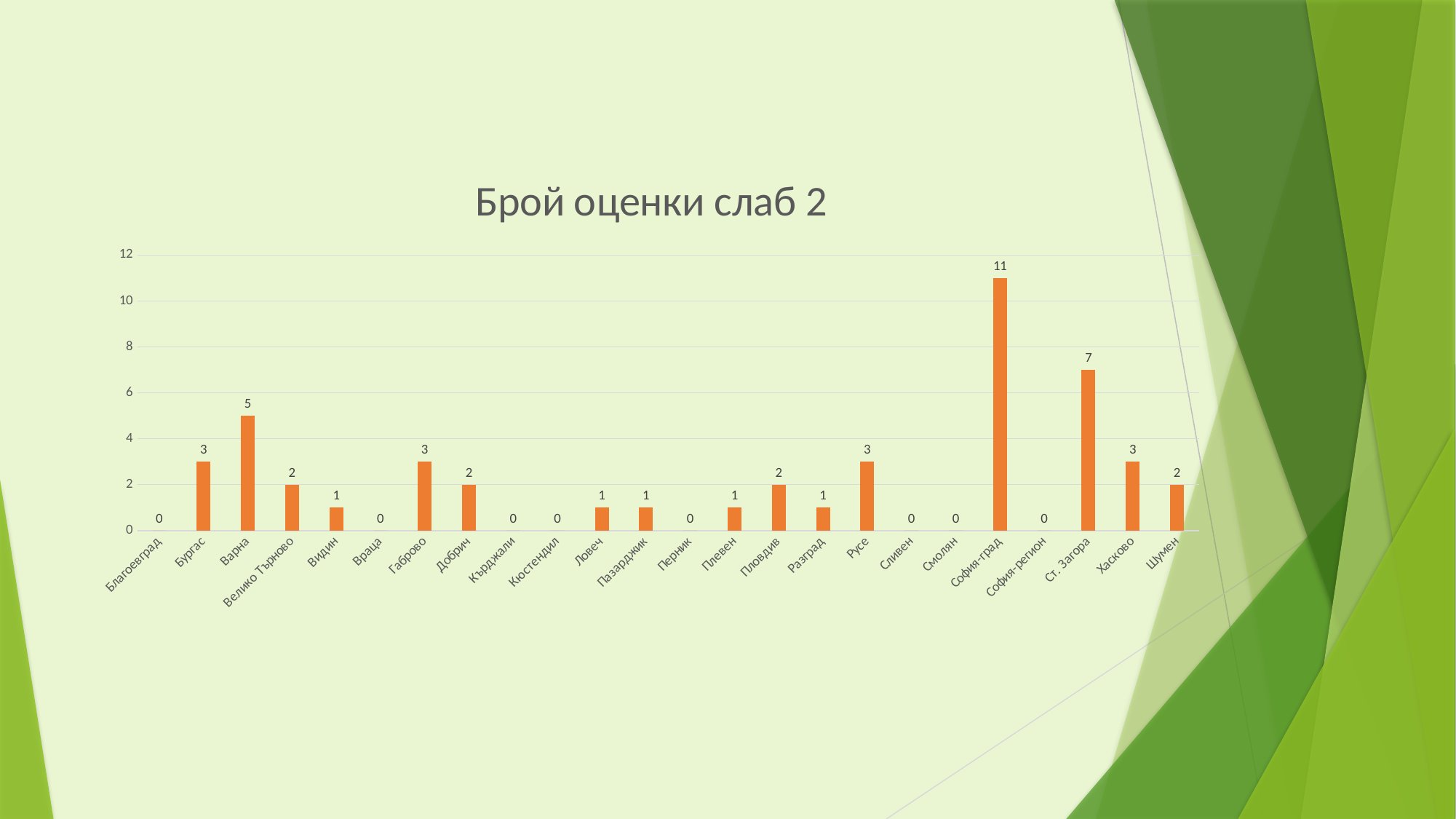
What is the title of the chart? Брой оценки слаб 2 What is the value for Ст. Загора? 7 How many categories are shown on the x axis? 24 Is the value for София-град greater or less than 10? greater Which category has the highest value? София-град What is the difference between the values for София-град and Ст. Загора? 4 What is the difference between the values for Варна and Бургас? 2 What is the value for София-град? 11 What is the value for Пловдив? 2 Which has a larger value, Варна or Ст. Загора? Ст. Загора What kind of chart is shown on the slide? bar chart What is the value for Варна? 5